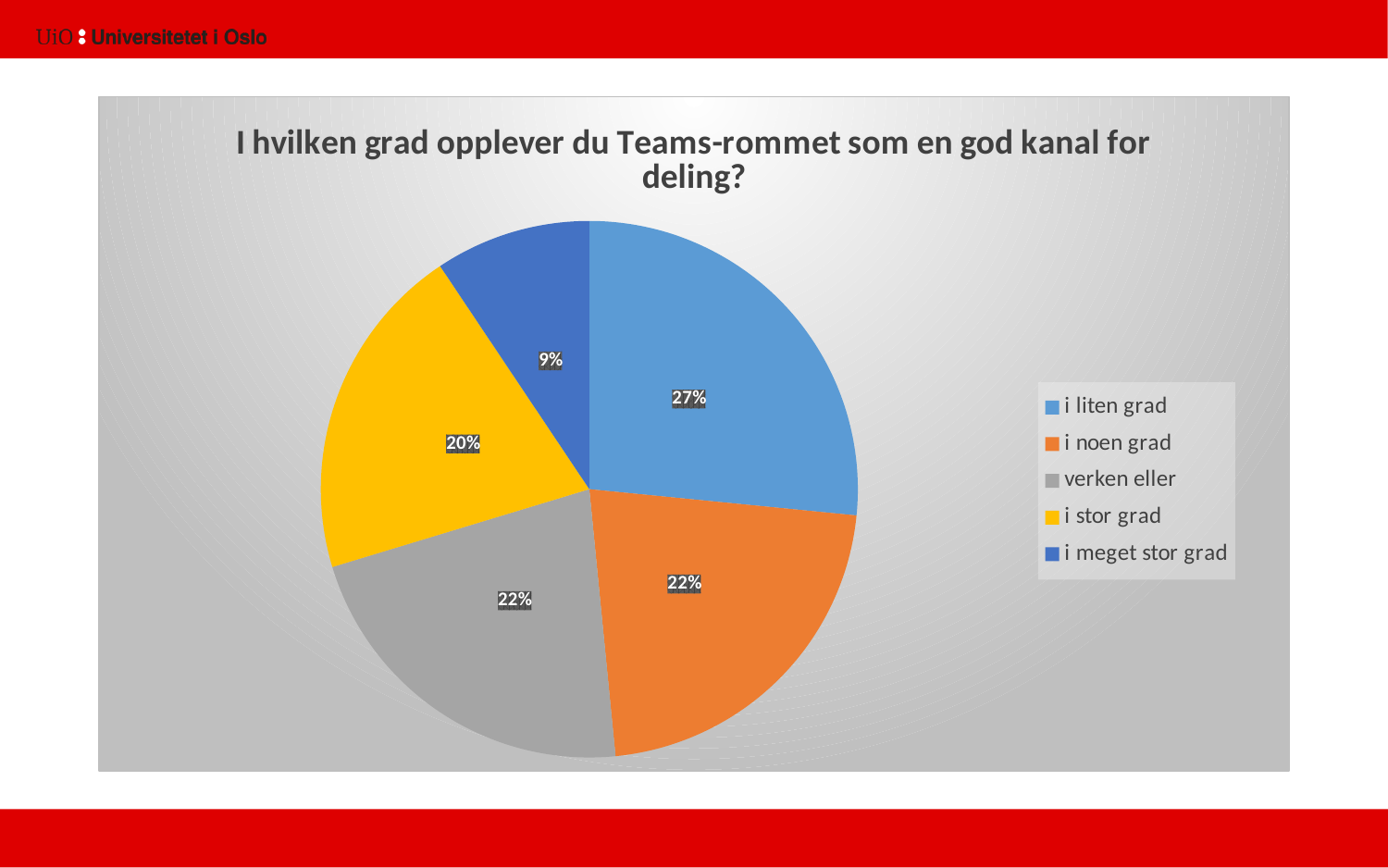
How many categories does the legend list? 5 What is the share for "i meget stor grad"? 9% What is the difference in percentage points between "i liten grad" and "i meget stor grad"? 18 What is the title of the chart? I hvilken grad opplever du Teams-rommet som en god kanal for deling? What kind of chart is shown on the slide? pie chart Which category has the smallest share of the pie? i meget stor grad Which category has the largest share of the pie? i liten grad What is the share for "i noen grad"? 22% What is the share for "i stor grad"? 20% Which is larger, the share for "i stor grad" or the share for "i meget stor grad"? i stor grad What is the share for "i liten grad"? 27% What colour is the slice for "verken eller"? grey